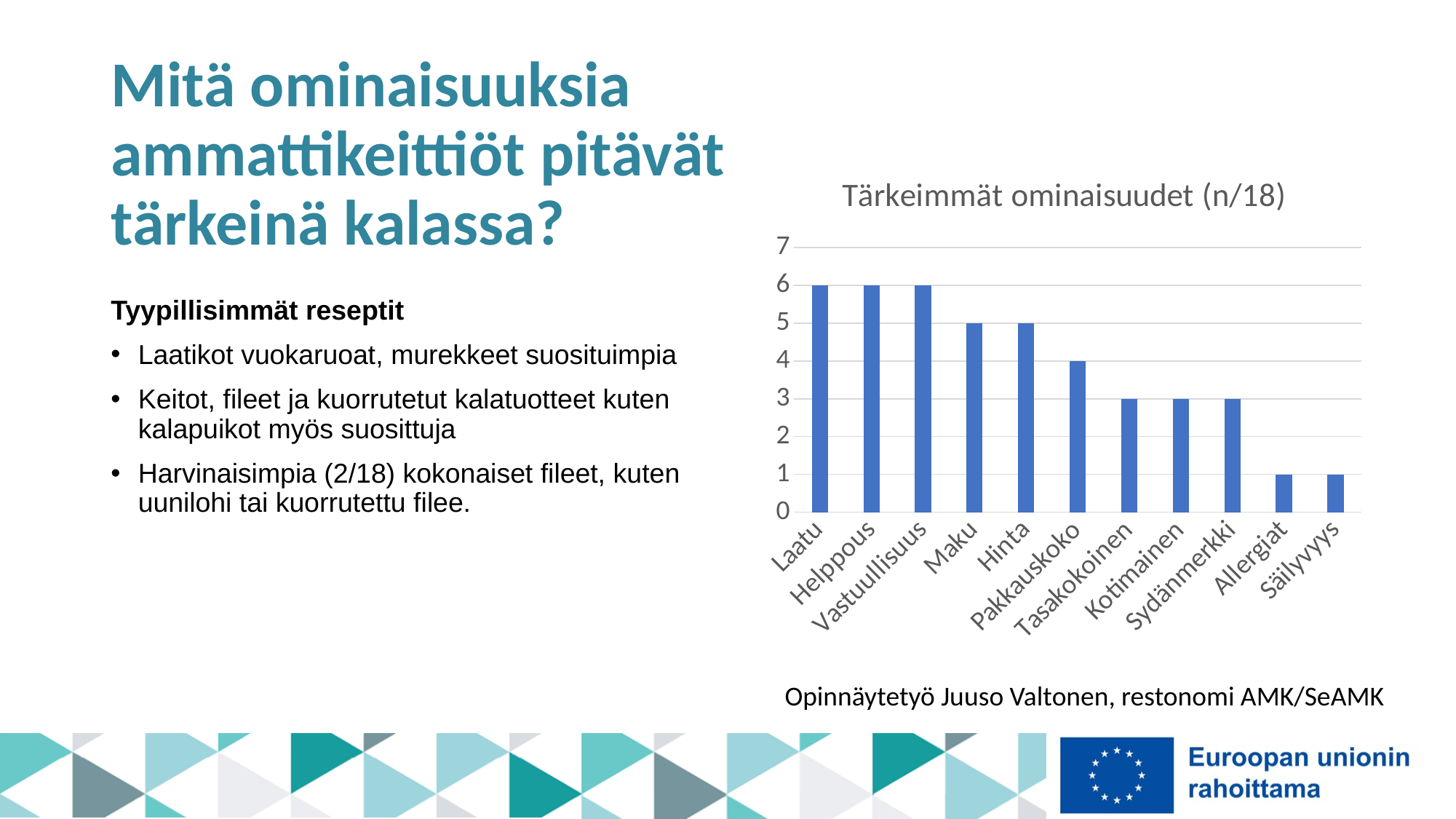
Which categories share the highest value in the chart? Laatu, Helppous, Vastuullisuus How many categories are shown on the x axis of the chart? 11 What is the value for Kotimainen? 3 What is the difference between the values for Laatu and Pakkauskoko? 2 What is the value for Pakkauskoko? 4 What is the value for Laatu? 6 Which is larger, the value for Maku or the value for Tasakokoinen? Maku What is the value for Säilyvyys? 1 Which categories share the lowest value in the chart? Allergiat, Säilyvyys Is the value for Hinta greater or less than 4? greater What is the title of the chart? Tärkeimmät ominaisuudet (n/18) What kind of chart is shown on the slide? Bar chart